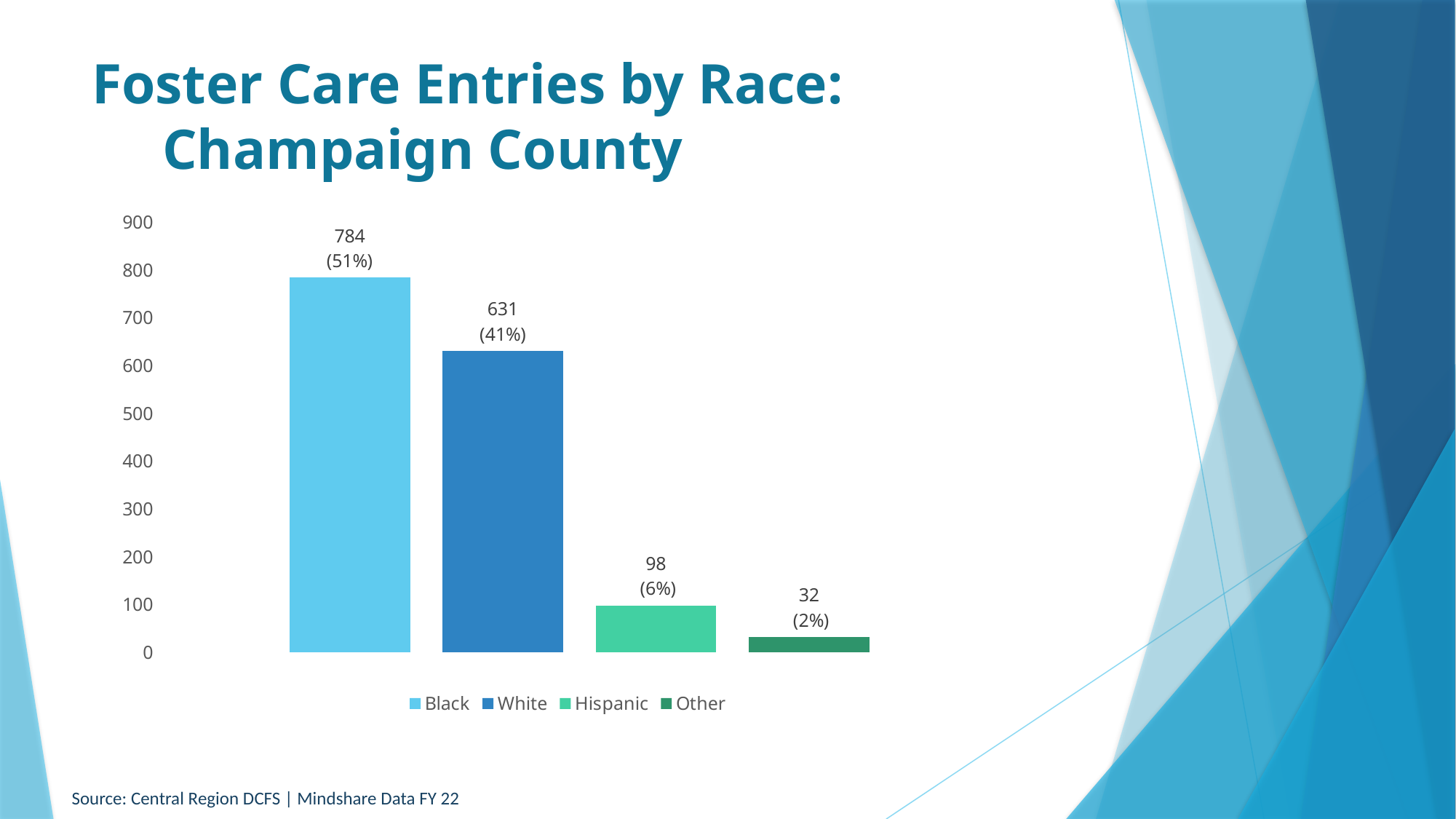
Which race category has the highest number of foster care entries? Black What is the source cited for the chart data? Central Region DCFS | Mindshare Data FY 22 What kind of chart is shown on the slide? Bar chart How many race categories are shown in the chart? 4 Which has more foster care entries, Hispanic or Other? Hispanic Is the value for White greater or less than 600? greater What is the difference in foster care entries between Black and White children? 153 What is the number of foster care entries for White children? 631 What is the number of foster care entries for Black children? 784 Which race category has the lowest number of foster care entries? Other What percentage of foster care entries is shown for Hispanic children? 6% What is the number of foster care entries for the Other category? 32